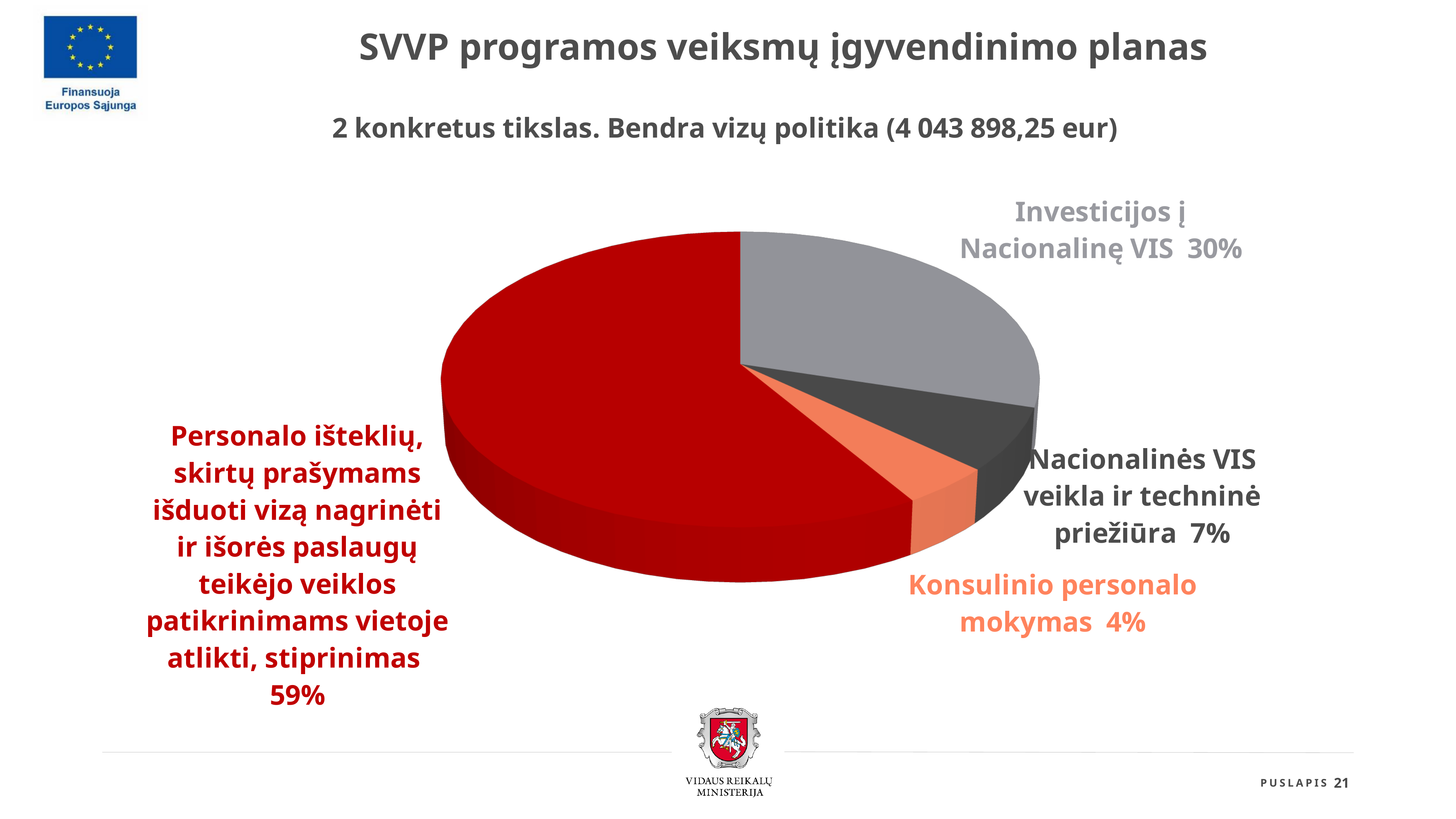
What is the difference in percentage points between "Investicijos į Nacionalinę VIS" and "Nacionalinės VIS veikla ir techninė priežiūra"? 23 percentage points What colour is the slice for "Investicijos į Nacionalinę VIS"? Grey Which is larger: the share for "Nacionalinės VIS veikla ir techninė priežiūra" or the share for "Konsulinio personalo mokymas"? Nacionalinės VIS veikla ir techninė priežiūra How many slices does the pie chart have? 4 What share of the pie does "Investicijos į Nacionalinę VIS" represent? 30% What share of the pie does "Konsulinio personalo mokymas" represent? 4% What share of the pie does "Nacionalinės VIS veikla ir techninė priežiūra" represent? 7% What kind of chart is shown on the slide? Pie chart Which slice of the pie is the largest? Personalo išteklių, skirtų prašymams išduoti vizą nagrinėti ir išorės paslaugų teikėjo veiklos patikrinimams vietoje atlikti, stiprinimas Which slice of the pie is the smallest? Konsulinio personalo mokymas What total amount in euros is stated in the chart subtitle for the specific objective "Bendra vizų politika"? 4 043 898,25 eur What share of the pie does the slice for "Personalo išteklių, skirtų prašymams išduoti vizą nagrinėti ir išorės paslaugų teikėjo veiklos patikrinimams vietoje atlikti, stiprinimas" represent? 59%